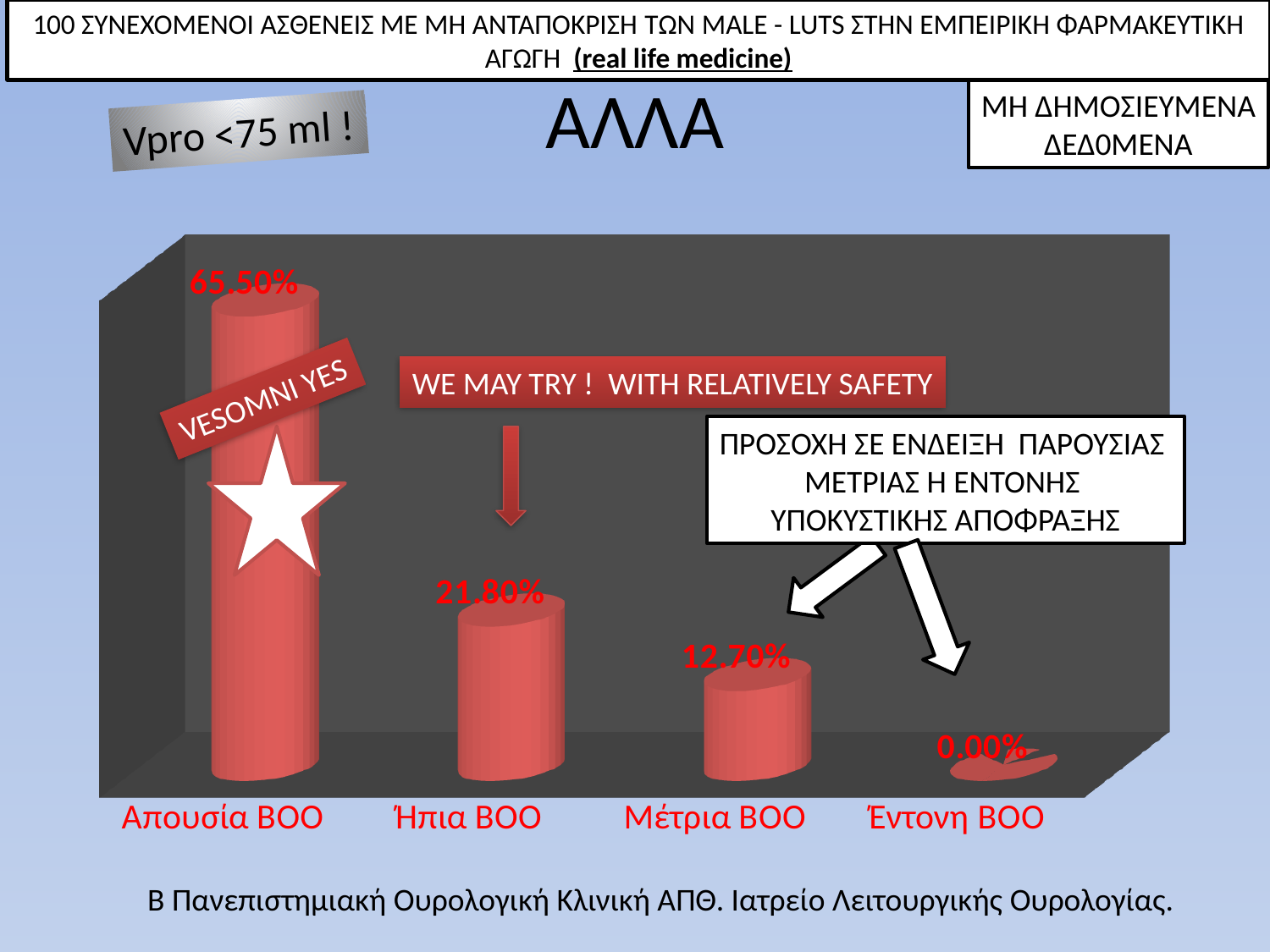
What is the difference between the values for Απουσία BOO and Ήπια BOO? 43.70% What is the value for Απουσία BOO? 65.50% What is the value for Έντονη BOO? 0.00% What is the value for Ήπια BOO? 21.80% Do the values rise or fall from left to right along the x axis? Fall What kind of chart is shown on the slide? Bar chart How many categories are shown in the chart? 4 Which category has the highest value? Απουσία BOO What is the difference between the values for Ήπια BOO and Μέτρια BOO? 9.10% What is the value for Μέτρια BOO? 12.70% Which is larger, the value for Ήπια BOO or the value for Μέτρια BOO? Ήπια BOO Which category has the lowest value? Έντονη BOO